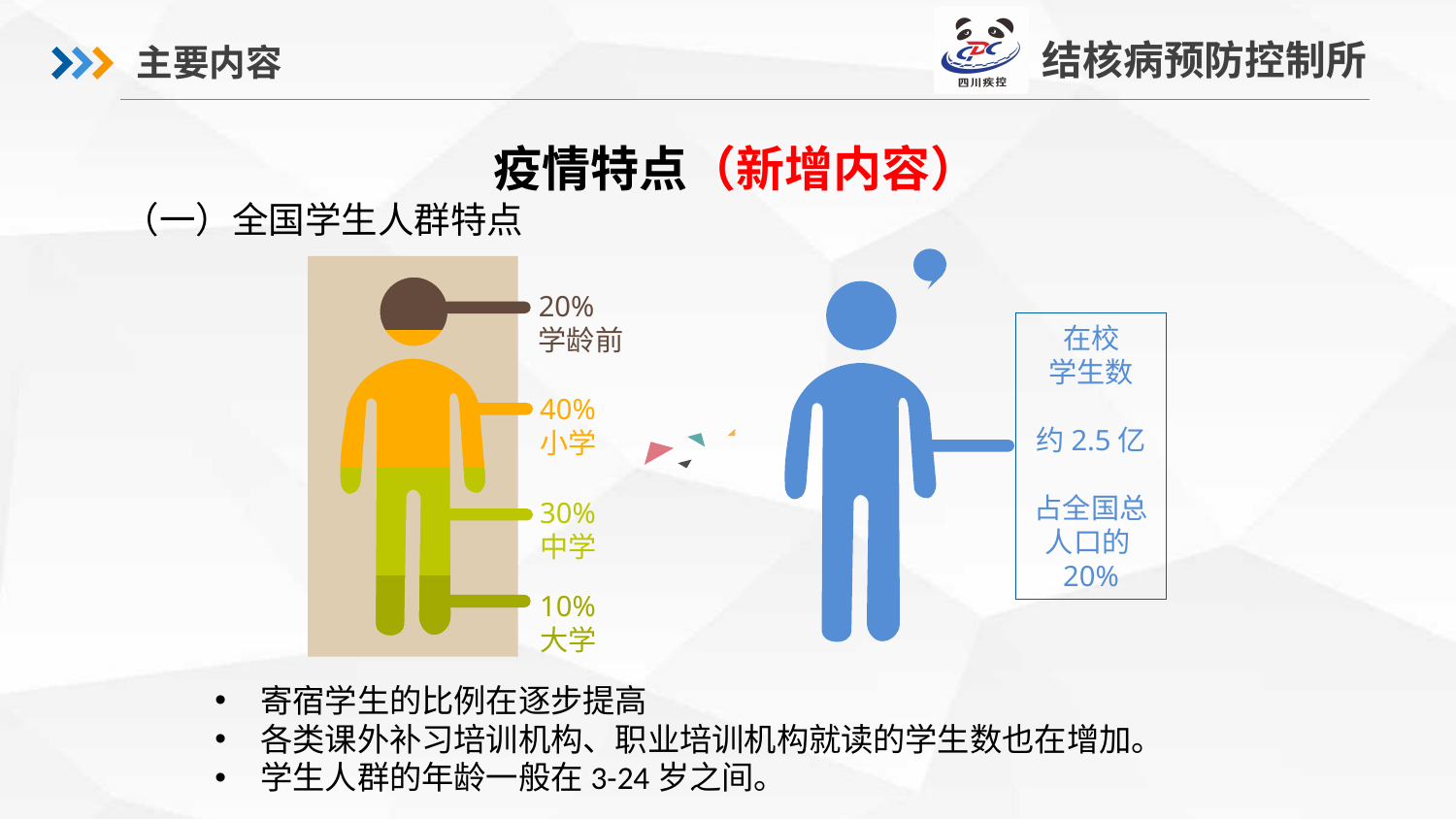
In the human-figure infographic, what percentage is shown for 学龄前 (preschool)? 20% Which student group has the lowest percentage in the human-figure infographic? 大学 Which has a larger percentage in the infographic, 学龄前 or 中学? 中学 What do the four percentages on the human-figure infographic add up to? 100% In the human-figure infographic, what percentage is shown for 小学 (primary school)? 40% In the human-figure infographic, what percentage is shown for 大学 (university)? 10% Which student group has the highest percentage in the human-figure infographic? 小学 How many student groups are labelled on the human-figure infographic? 4 According to the text box next to the blue figure, what share of the national population do in-school students make up? 20% In the human-figure infographic, what percentage is shown for 中学 (secondary school)? 30% What is the difference between the percentages for 小学 and 中学 in the infographic? 10% According to the text box next to the blue figure, approximately how many students are enrolled in school (在校学生数)? 约 2.5 亿